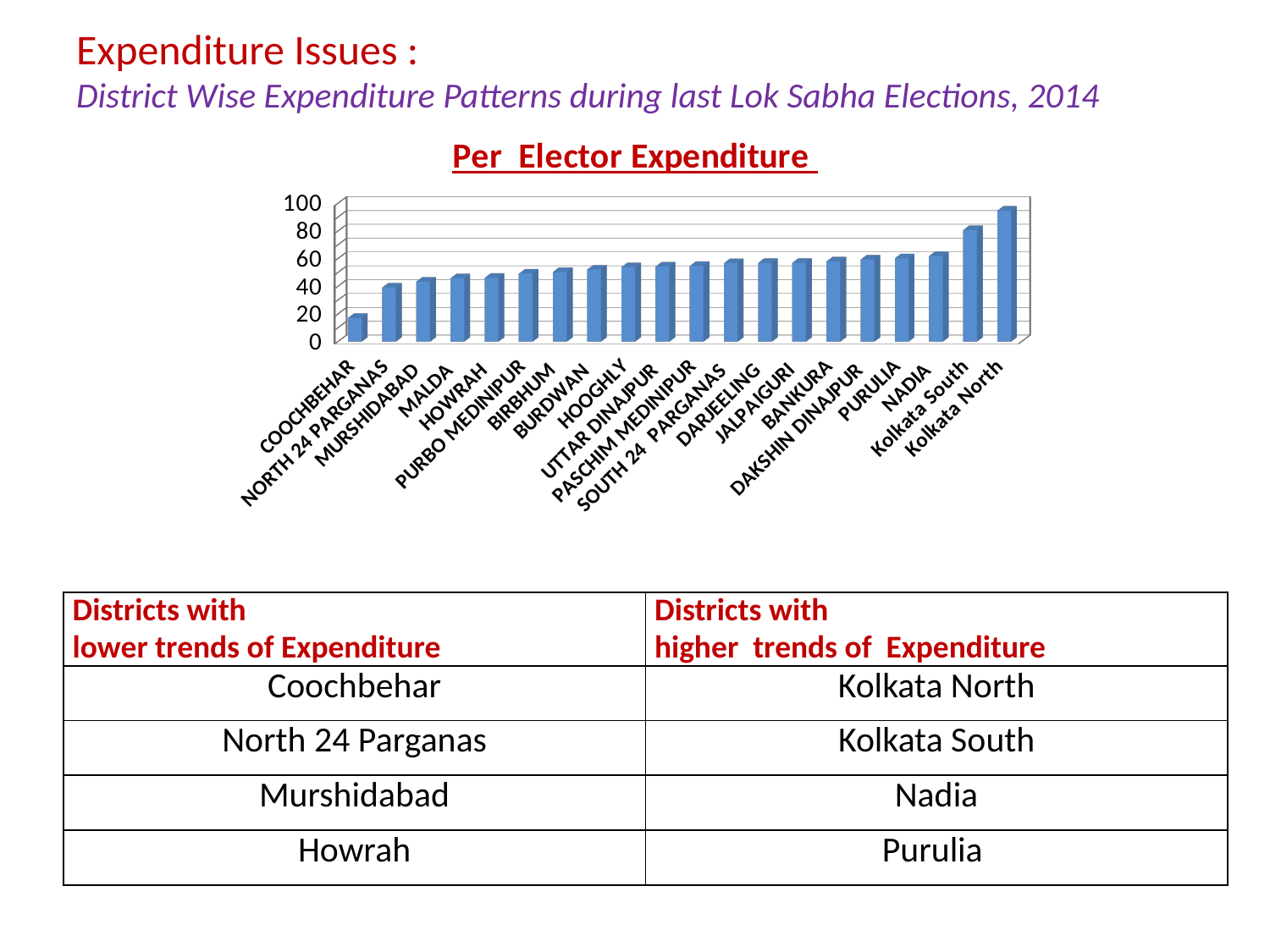
Which district has the highest per elector expenditure? Kolkata North Which district has the lowest per elector expenditure? COOCHBEHAR Which has a higher per elector expenditure, Kolkata South or MALDA? Kolkata South What is the title of the chart? Per Elector Expenditure Is the value for COOCHBEHAR greater or less than 20? less Is the value for Kolkata North greater or less than 80? greater Is the value for HOOGHLY greater or less than 40? greater What kind of chart is shown on the slide? bar chart Do the values rise or fall moving from left to right along the x axis? rise How many districts are plotted on the chart? 20